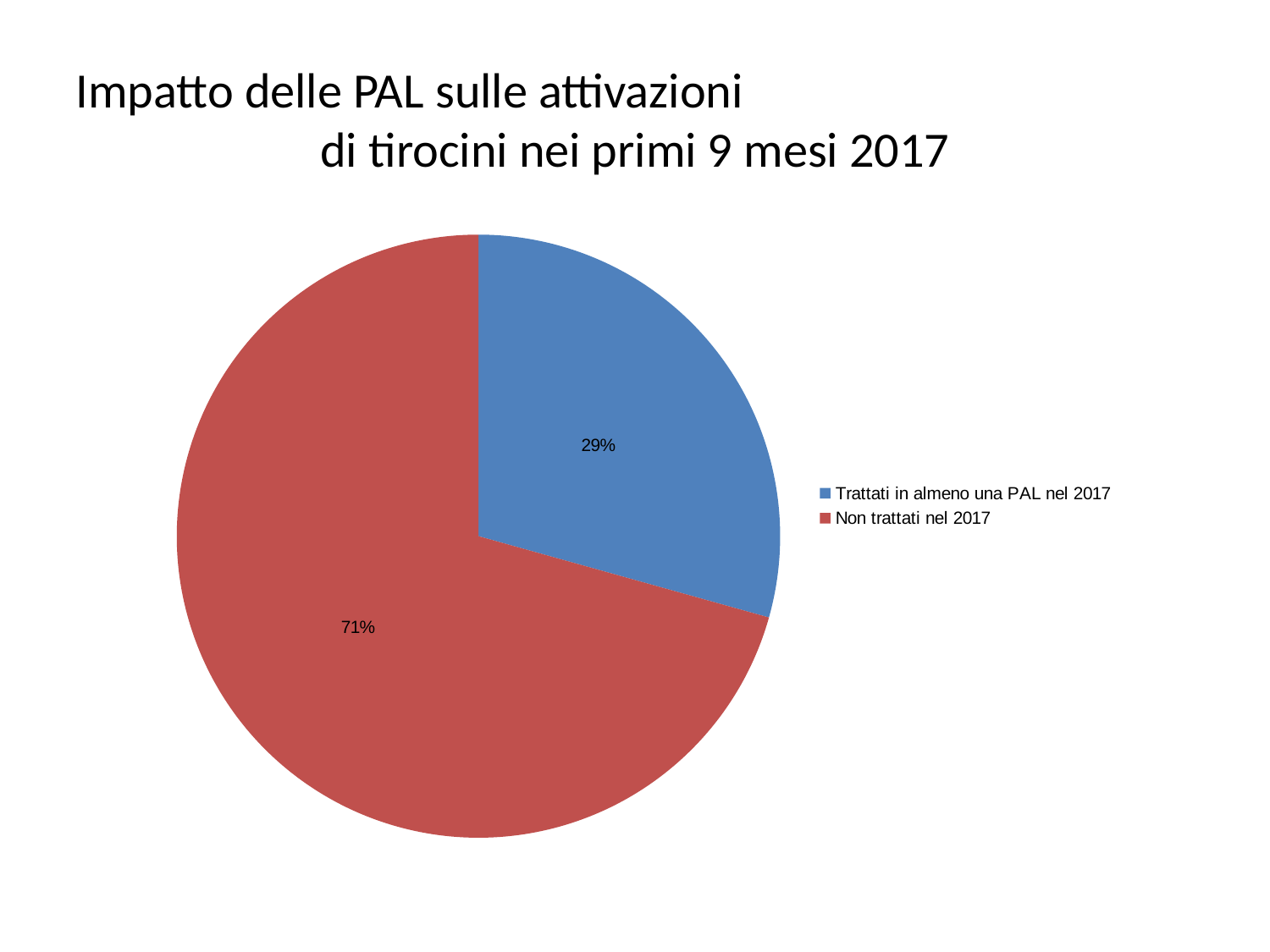
How many slices does the pie chart have? 2 Which slice of the pie is the smallest? Trattati in almeno una PAL nel 2017 Which slice of the pie is the largest? Non trattati nel 2017 What share of the pie is labelled "Non trattati nel 2017"? 71% What is the difference in percentage points between the "Non trattati nel 2017" slice and the "Trattati in almeno una PAL nel 2017" slice? 42 percentage points How many entries does the legend list? 2 What kind of chart is shown on the slide? pie chart Which is larger: the share for "Trattati in almeno una PAL nel 2017" or the share for "Non trattati nel 2017"? Non trattati nel 2017 What is the title of the slide? Impatto delle PAL sulle attivazioni di tirocini nei primi 9 mesi 2017 What share of the pie is labelled "Trattati in almeno una PAL nel 2017"? 29% What colour is the slice for "Non trattati nel 2017"? red